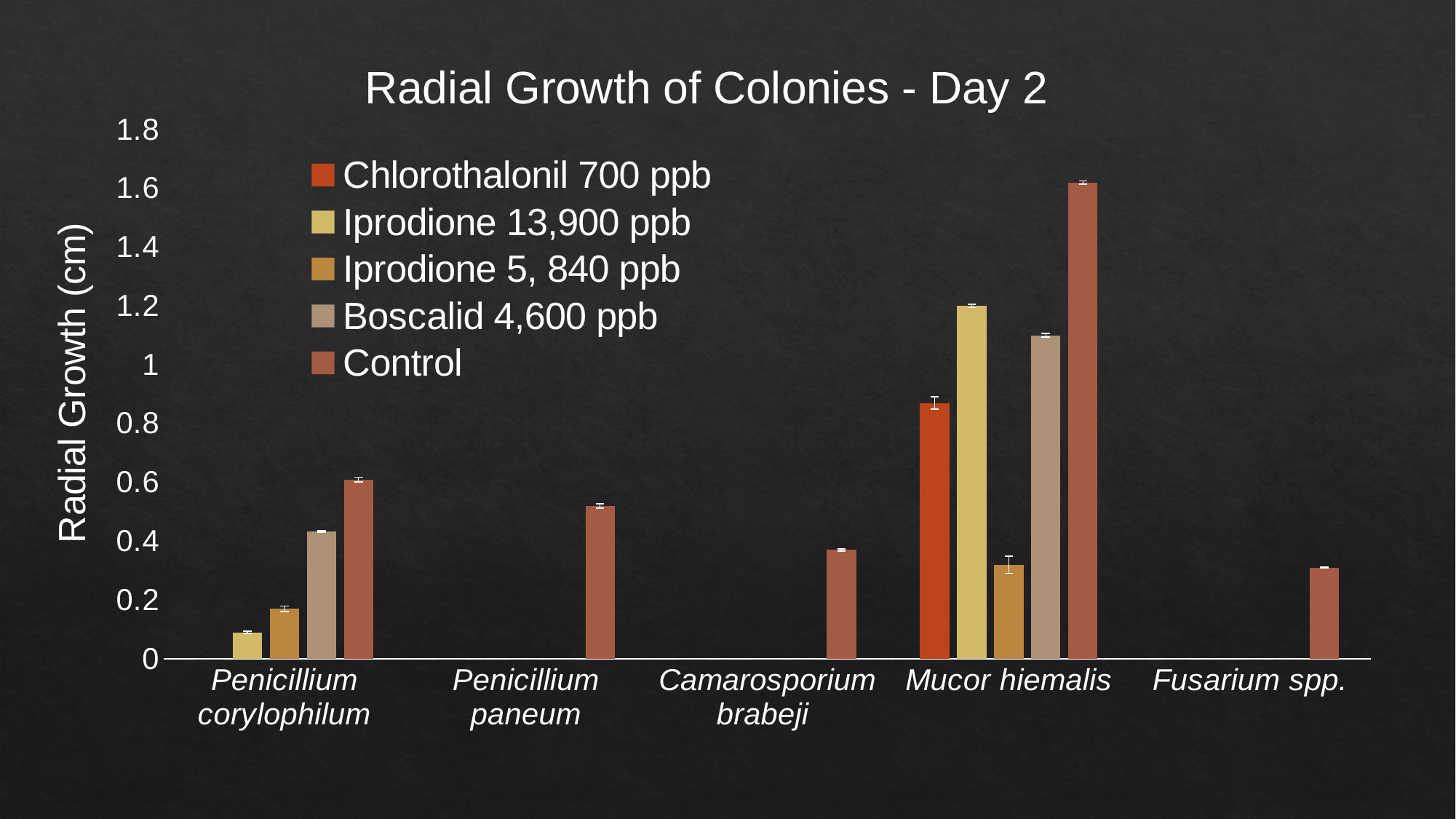
For Mucor hiemalis, which is larger, the Boscalid 4,600 ppb value or the Chlorothalonil 700 ppb value? Boscalid 4,600 ppb Is the Control value for Fusarium spp. greater or less than 0.4? less What is the title of the chart? Radial Growth of Colonies - Day 2 What is the label on the vertical axis? Radial Growth (cm) Is the Chlorothalonil 700 ppb value for Mucor hiemalis greater or less than 1? less What type of chart is shown on the slide? Bar chart How many series does the legend list? 5 Is the Control value for Mucor hiemalis greater or less than 1.4? greater How many species categories are shown on the x axis? 5 Which is larger, the Control value for Penicillium corylophilum or the Control value for Penicillium paneum? Penicillium corylophilum Which species has the tallest Control bar? Mucor hiemalis